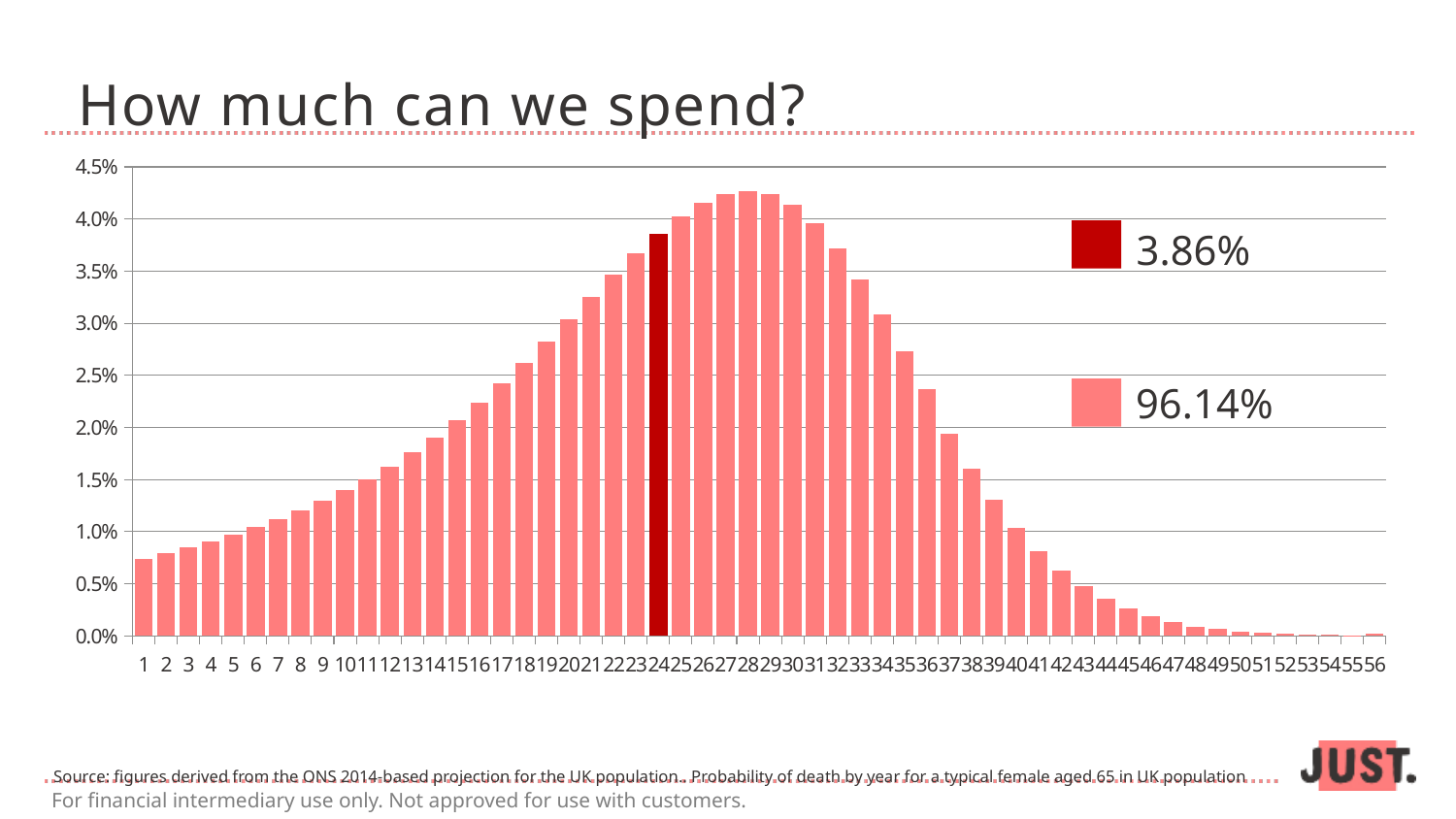
Which is larger, the value for category 24 or the value for category 30? category 30 Is the value for category 1 greater or less than 1.0%? less What kind of chart is shown on the slide? bar chart What is the title of the slide? How much can we spend? Is the value for category 45 greater or less than 0.5%? less Is the value for category 40 greater or less than 1.5%? less What value is shown for the dark red bar at category 24? 3.86% Do the values rise or fall from category 30 to category 56? fall Which is larger, the value for category 20 or the value for category 40? category 20 What percentage is shown next to the light red legend square? 96.14% How many categories are plotted along the x axis? 56